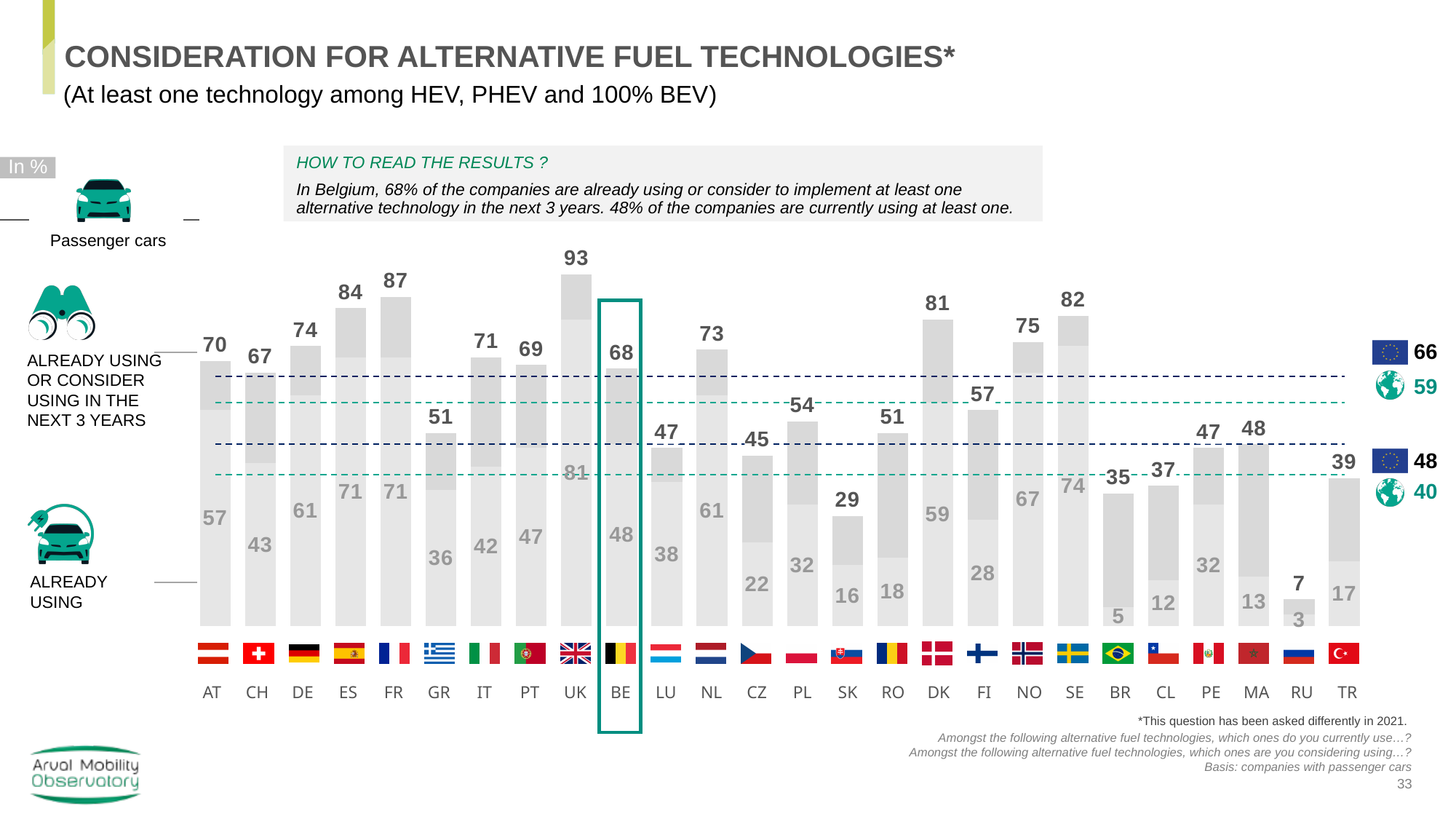
What is the difference between the 'already using or consider using' value and the 'already using' value for France (FR)? 16 Which country has a higher 'already using' value, Germany (DE) or the Netherlands (NL)? They are equal (61) Which country has the highest value for 'already using or consider using in the next 3 years'? UK What is the global average for 'already using' shown on the right of the chart? 40 What percentage of companies in the UK are already using or consider using at least one alternative fuel technology in the next 3 years? 93 What is the EU average for 'already using or consider using in the next 3 years' shown on the right of the chart? 66 What type of chart is shown on the slide? Bar chart What is the 'already using or consider using' value for Slovakia (SK)? 29 How many countries are shown on the chart? 26 Which country has a higher 'already using or consider using' value, Denmark (DK) or Sweden (SE)? SE Which country has the lowest 'already using' value? RU What is the 'already using' value for Belgium (BE)? 48